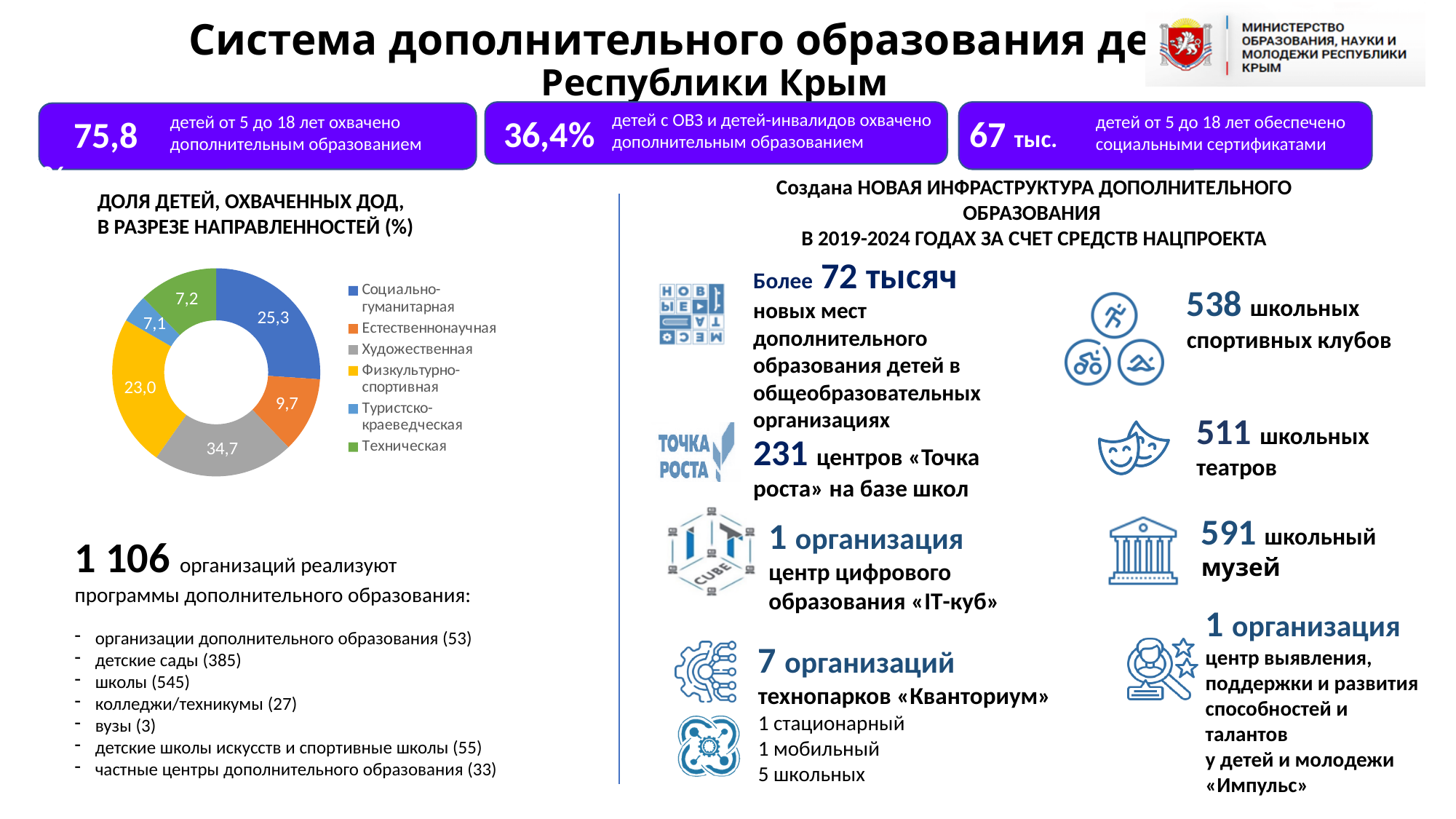
What is the value for Техническая in the doughnut chart? 7,2 What is the value for Естественнонаучная in the doughnut chart? 9,7 Which is larger in the doughnut chart: Физкультурно-спортивная or Естественнонаучная? Физкультурно-спортивная How many categories does the doughnut chart show? 6 What is the difference between the values for Художественная and Социально-гуманитарная? 9,4 What is the title of the doughnut chart? ДОЛЯ ДЕТЕЙ, ОХВАЧЕННЫХ ДОД, В РАЗРЕЗЕ НАПРАВЛЕННОСТЕЙ (%) What is the value for Художественная in the doughnut chart? 34,7 What is the value for Туристско-краеведческая in the doughnut chart? 7,1 What is the value for Социально-гуманитарная in the doughnut chart? 25,3 Which category has the largest share in the doughnut chart? Художественная What is the value for Физкультурно-спортивная in the doughnut chart? 23,0 What kind of chart is shown on the slide? Doughnut (pie) chart